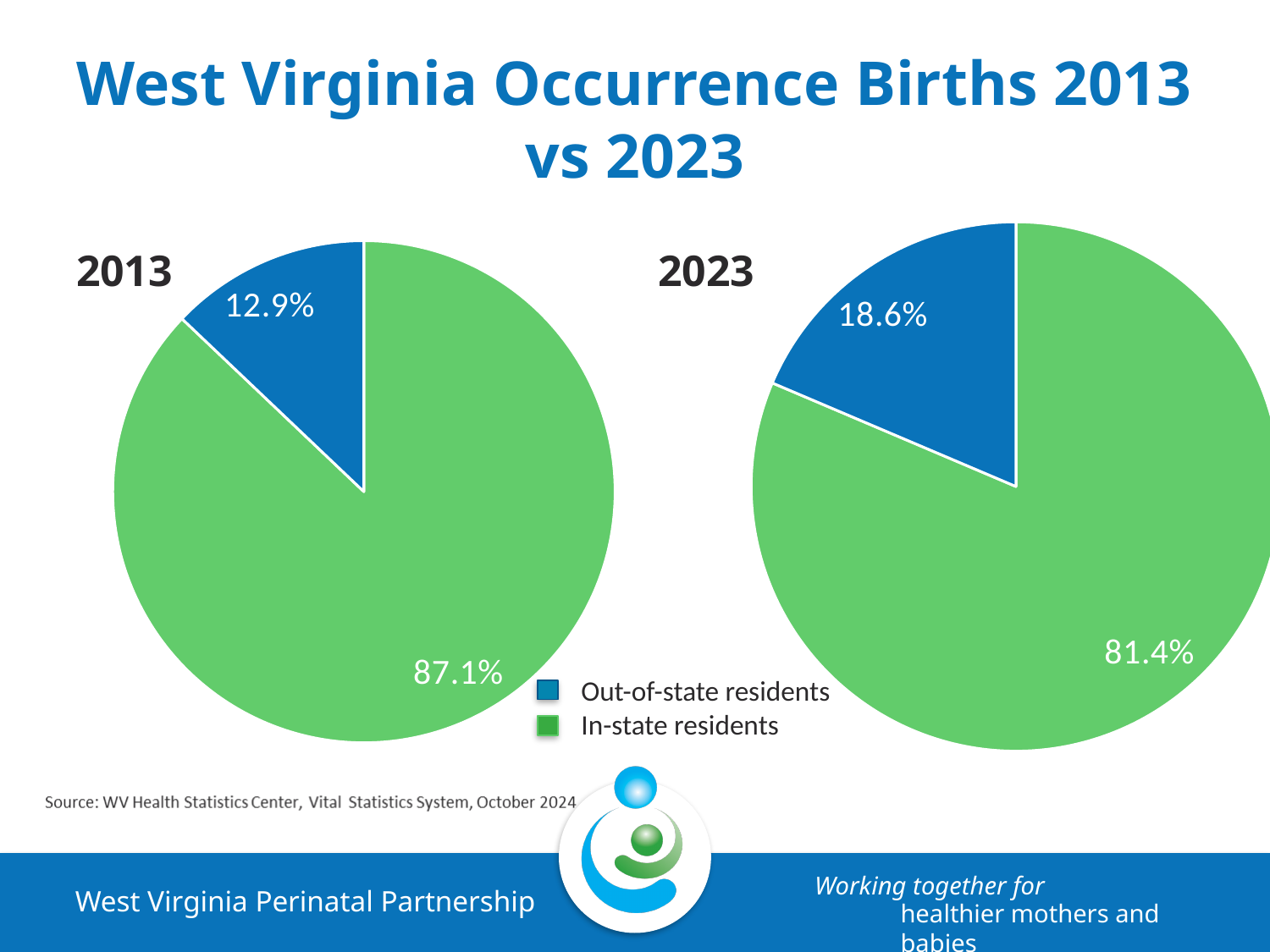
In the 2013 pie chart, what share of occurrence births were to out-of-state residents? 12.9% By how many percentage points did the out-of-state residents share change from the 2013 pie chart to the 2023 pie chart? 5.7 percentage points In the 2013 pie chart, what is the difference between the in-state and out-of-state residents shares? 74.2 percentage points In the 2023 pie chart, what share of occurrence births were to in-state residents? 81.4% In the 2023 pie chart, what share of occurrence births were to out-of-state residents? 18.6% What type of chart is used to show the 2013 data? Pie chart How many slices does the 2023 pie chart have? 2 Which colour represents in-state residents in the legend? Green In the 2023 pie chart, which category has the largest slice? In-state residents Comparing the two pie charts, which year has the larger out-of-state residents share, 2013 or 2023? 2023 In the 2013 pie chart, which category has the smallest slice? Out-of-state residents In the 2013 pie chart, what share of occurrence births were to in-state residents? 87.1%